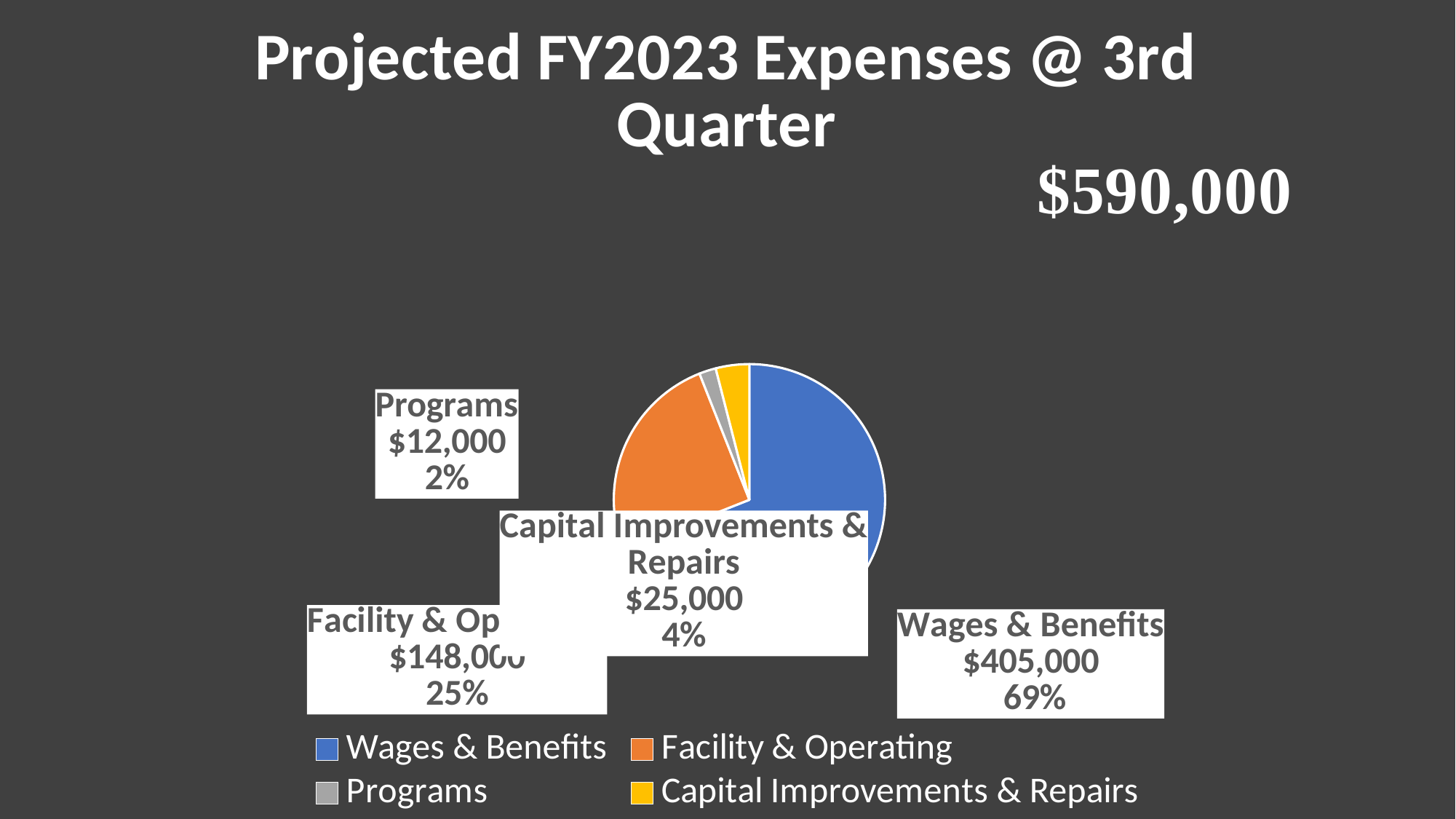
Which expense category has the largest share of the pie? Wages & Benefits Which expense category has the smallest share of the pie? Programs What is the projected expense value for Wages & Benefits? $405,000 What percentage of projected expenses is Wages & Benefits? 69% What is the projected expense value for Programs? $12,000 Which is larger, Capital Improvements & Repairs or Programs? Capital Improvements & Repairs How many expense categories does the legend list? 4 What is the difference between the Capital Improvements & Repairs and Programs expense values? $13,000 What percentage of projected expenses is Facility & Operating? 25% What is the projected expense value for Capital Improvements & Repairs? $25,000 What kind of chart is shown on the slide? pie chart What percentage of projected expenses is Capital Improvements & Repairs? 4%